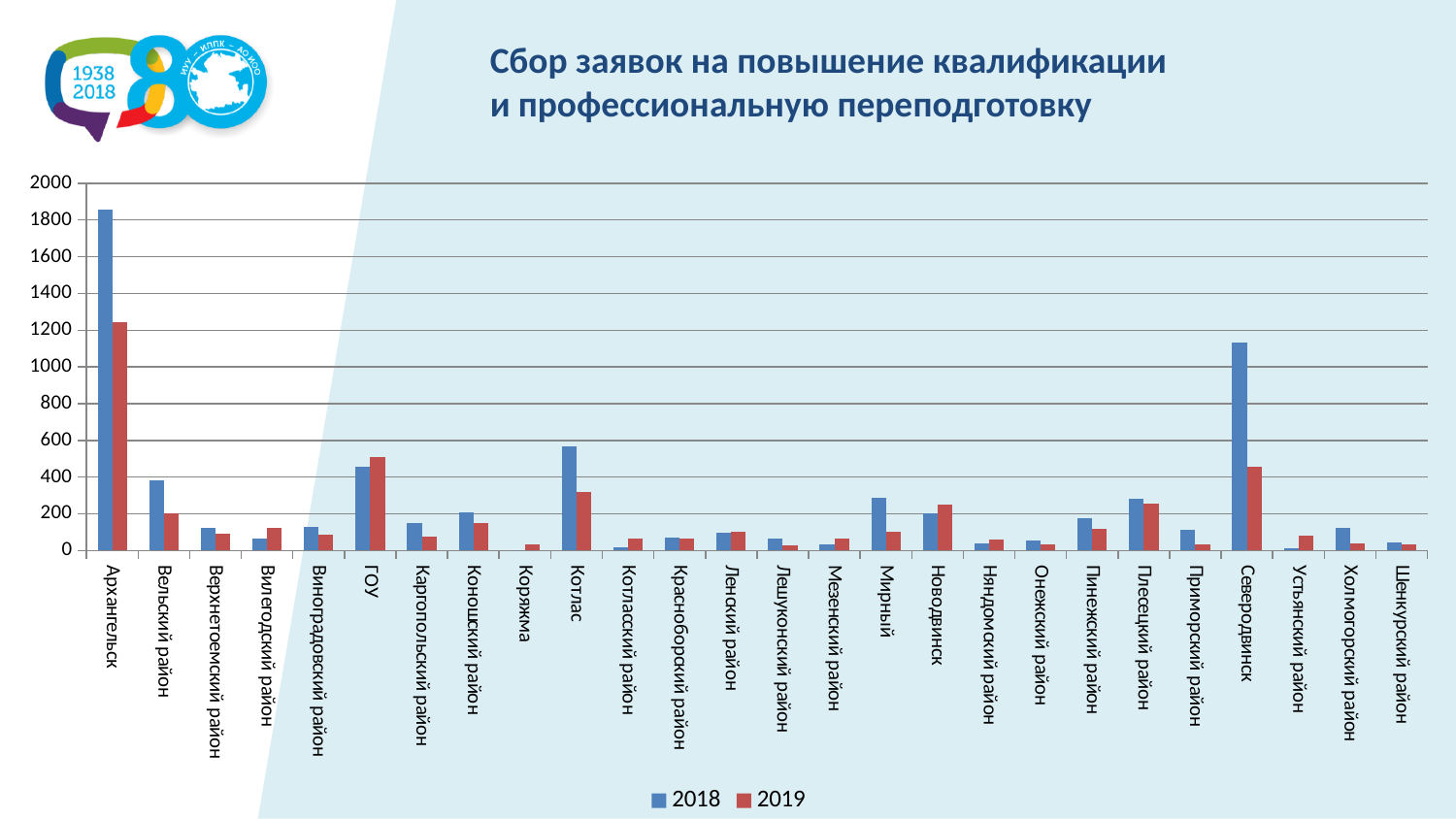
How many categories are shown along the x axis? 26 Is the 2019 value for Котлас greater or less than 400? less Which years are listed in the legend? 2018 and 2019 Is the 2018 value for Архангельск greater or less than 1600? greater How many series does the legend list? 2 Which category has the highest value for 2018? Архангельск Is the 2018 value for Северодвинск greater or less than 1000? greater Which category has the highest value for 2019? Архангельск For Архангельск, which is larger: the 2018 value or the 2019 value? 2018 What kind of chart is shown on the slide? bar chart For Новодвинск, which is larger: the 2018 value or the 2019 value? 2019 For Котлас, which is larger: the 2018 value or the 2019 value? 2018